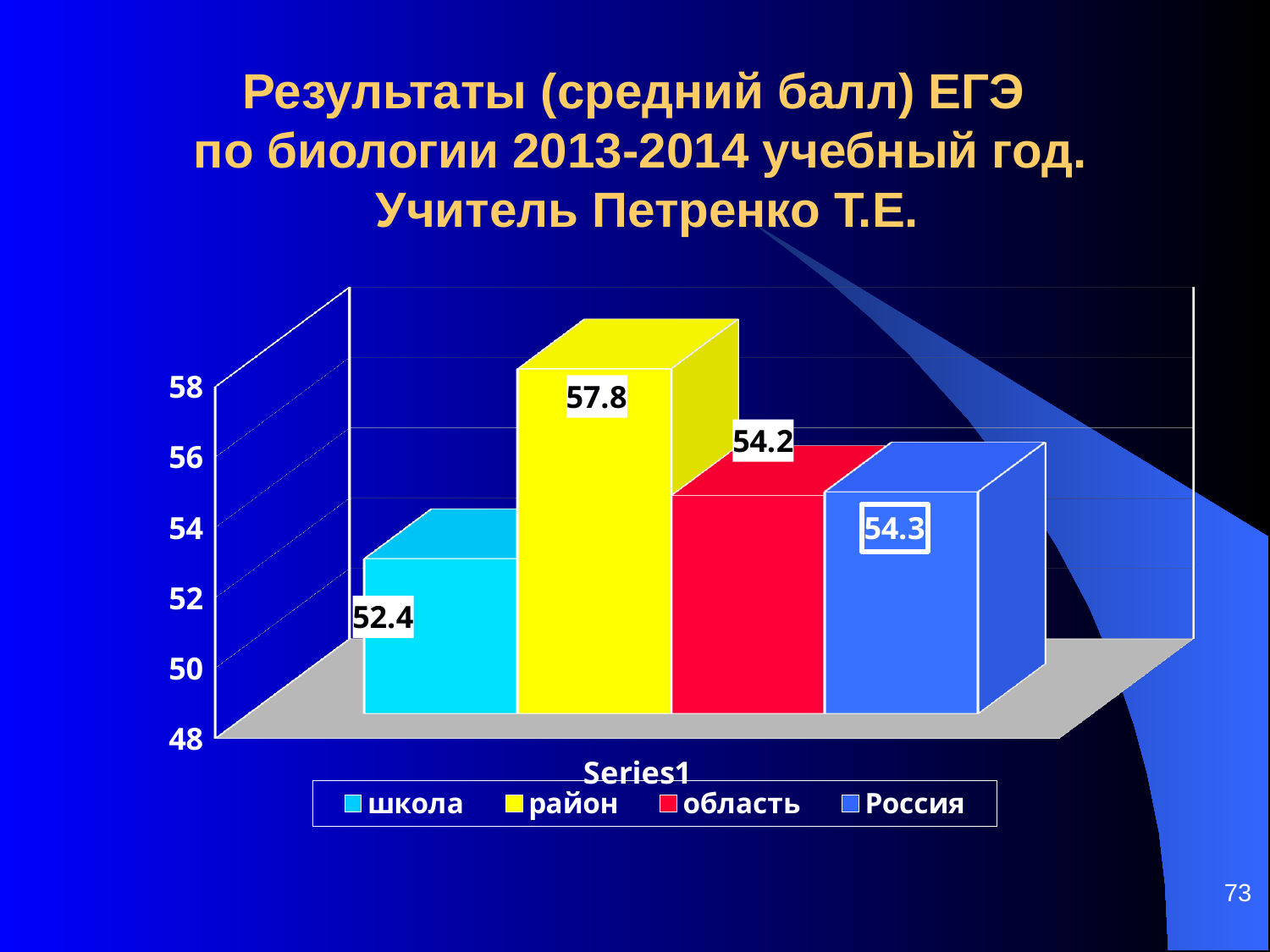
How many entries does the legend list? 4 What is the difference between the values for район and школа? 5.4 Which category has the lowest value? школа Is the value for школа greater or less than 54? less What kind of chart is shown on the slide? bar chart What is the value for школа? 52.4 How many bars are shown in the chart? 4 Which is larger, the value for район or the value for область? район What is the value for район? 57.8 Which category has the highest value? район What is the value for область? 54.2 What is the value for Россия? 54.3